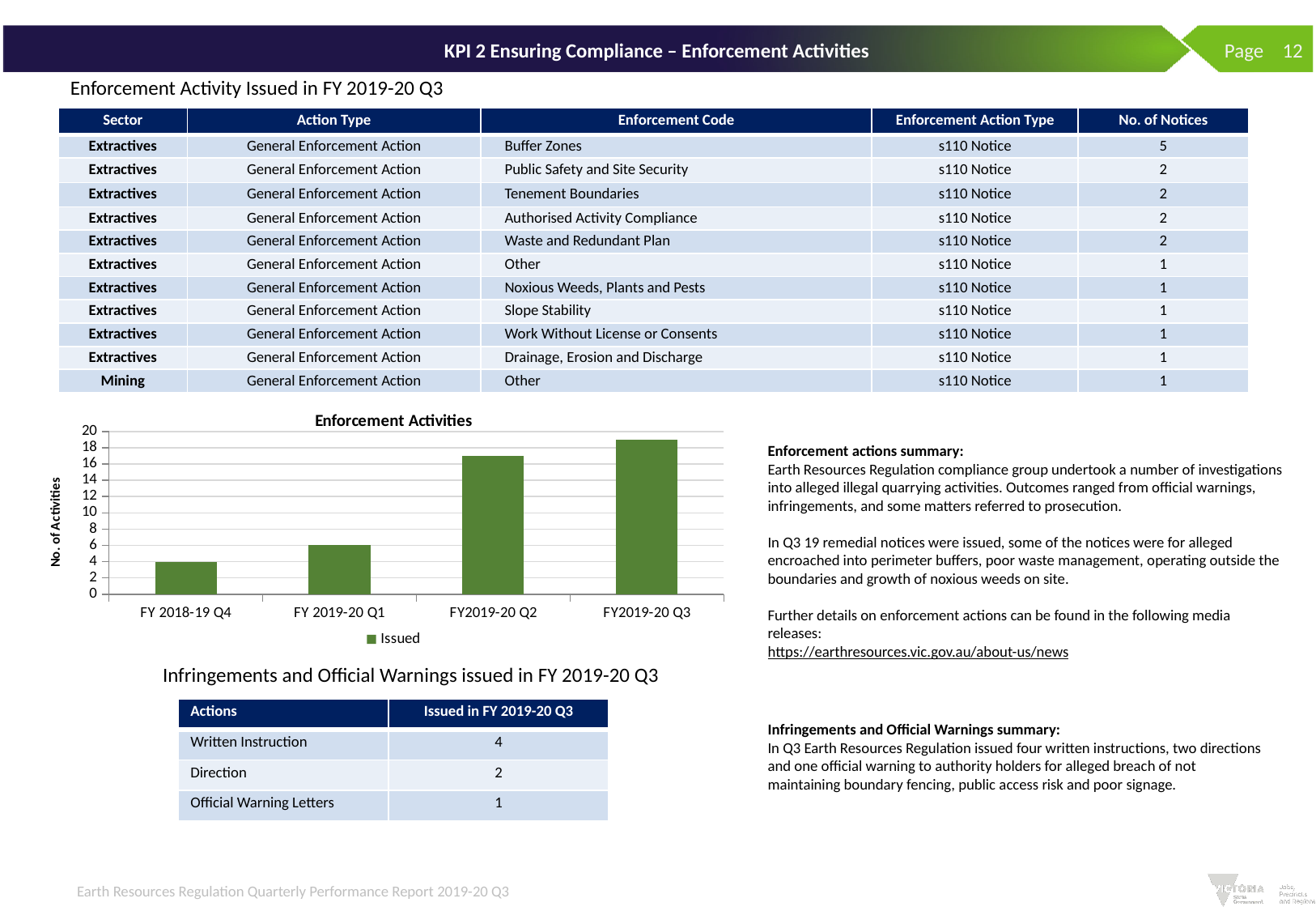
In the "Enforcement Activities" chart, what is the value for FY 2019-20 Q1? 6 What is the legend entry shown below the "Enforcement Activities" chart? Issued Which quarter has the highest value in the "Enforcement Activities" chart? FY2019-20 Q3 How many categories are shown on the x axis of the "Enforcement Activities" chart? 4 In the "Enforcement Activities" chart, is the value for FY2019-20 Q3 greater or less than 16? greater What kind of chart is the "Enforcement Activities" chart? bar chart How many series does the legend of the "Enforcement Activities" chart list? 1 In the "Enforcement Activities" chart, is the value for FY2019-20 Q2 greater or less than 10? greater In the "Enforcement Activities" chart, what is the value for FY 2018-19 Q4? 4 In the "Enforcement Activities" chart, which is larger: FY 2019-20 Q1 or FY2019-20 Q2? FY2019-20 Q2 Which quarter has the lowest value in the "Enforcement Activities" chart? FY 2018-19 Q4 Do the values in the "Enforcement Activities" chart rise or fall from FY 2018-19 Q4 to FY2019-20 Q3? rise